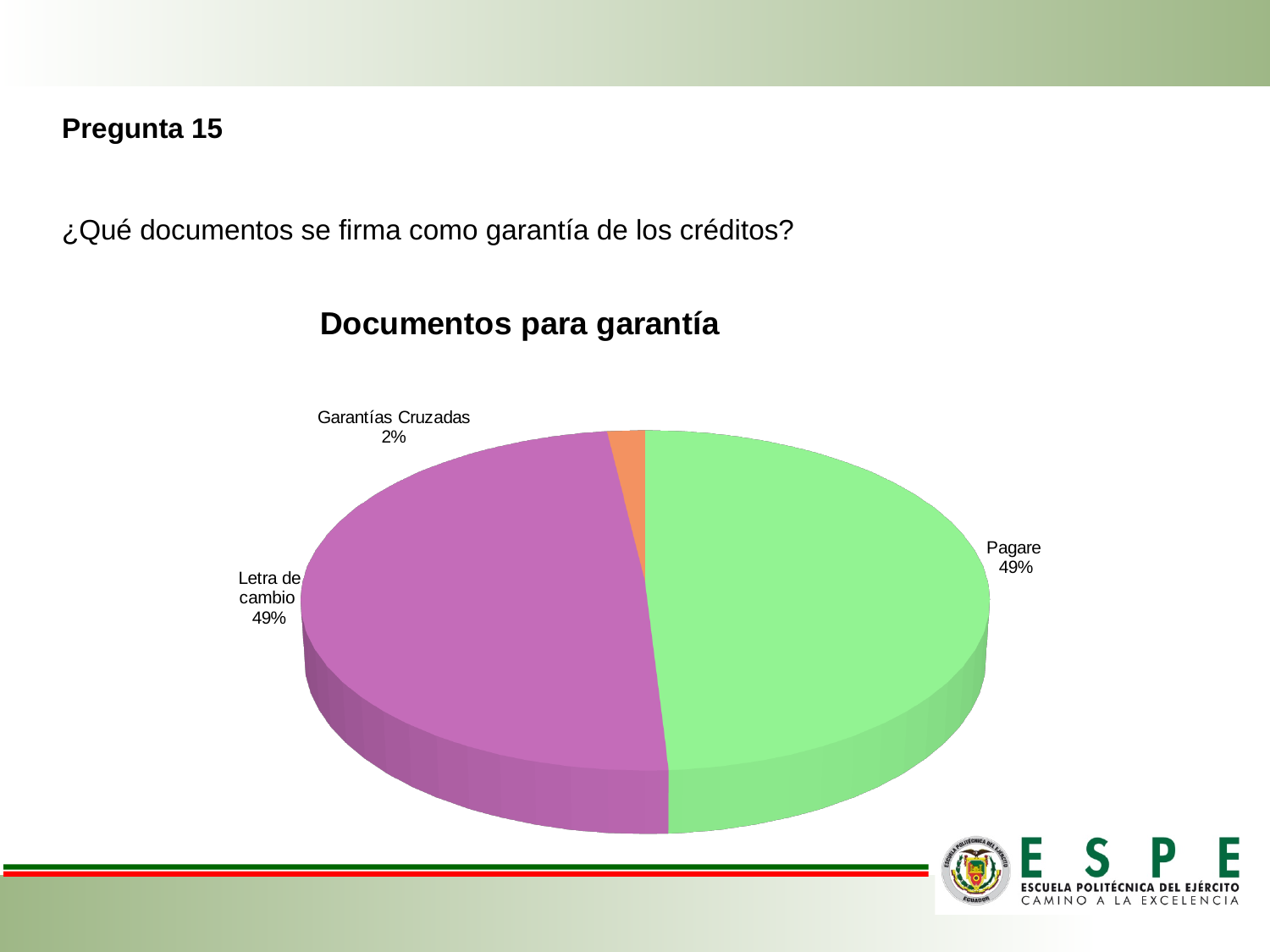
What kind of chart is shown on the slide? Pie chart Which category has the smallest share of the pie? Garantías Cruzadas What is the difference in percentage points between Pagare and Garantías Cruzadas? 47 What percentage of the pie does Pagare represent? 49% Is the share for Pagare greater or less than 25%? greater What percentage of the pie does Letra de cambio represent? 49% What percentage of the pie does Garantías Cruzadas represent? 2% What is the combined share of Pagare and Letra de cambio? 98% What colour is the Pagare slice? Green Which is larger, the share for Letra de cambio or the share for Garantías Cruzadas? Letra de cambio What is the title of the chart? Documentos para garantía How many slices does the pie chart have? 3